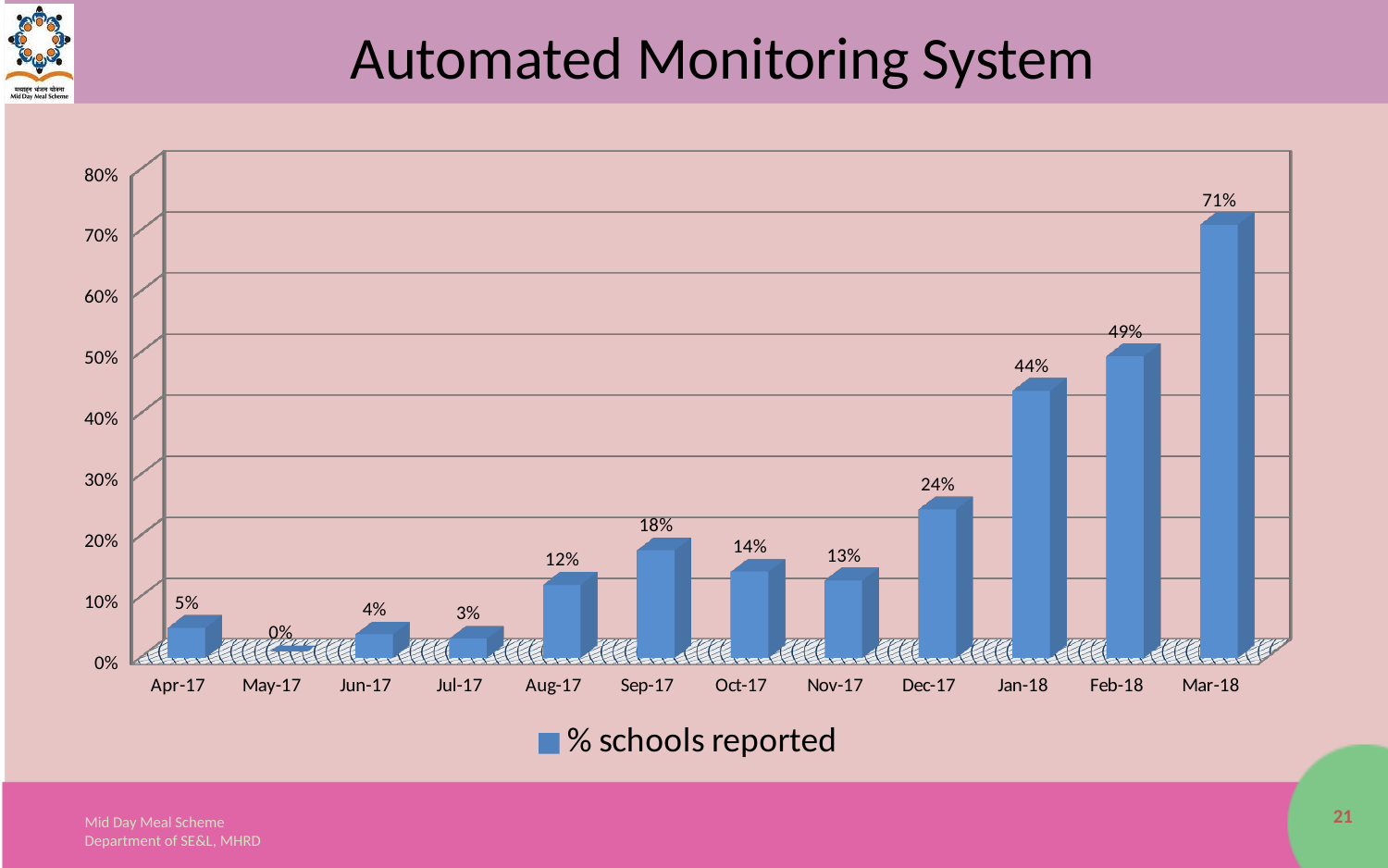
Which month has the lowest % schools reported? May-17 What is the value for Aug-17? 12% What is the difference between the values for Mar-18 and Feb-18? 22% What is the value for Dec-17? 24% Is the value for Jan-18 greater or less than 40%? greater What is the legend entry for the series shown? % schools reported Which is larger, the value for Sep-17 or the value for Oct-17? Sep-17 What is the difference between the values for Jan-18 and Dec-17? 20% What is the value for Mar-18? 71% Which month has the highest % schools reported? Mar-18 What kind of chart is shown on the slide? Bar chart How many months are shown on the x axis? 12